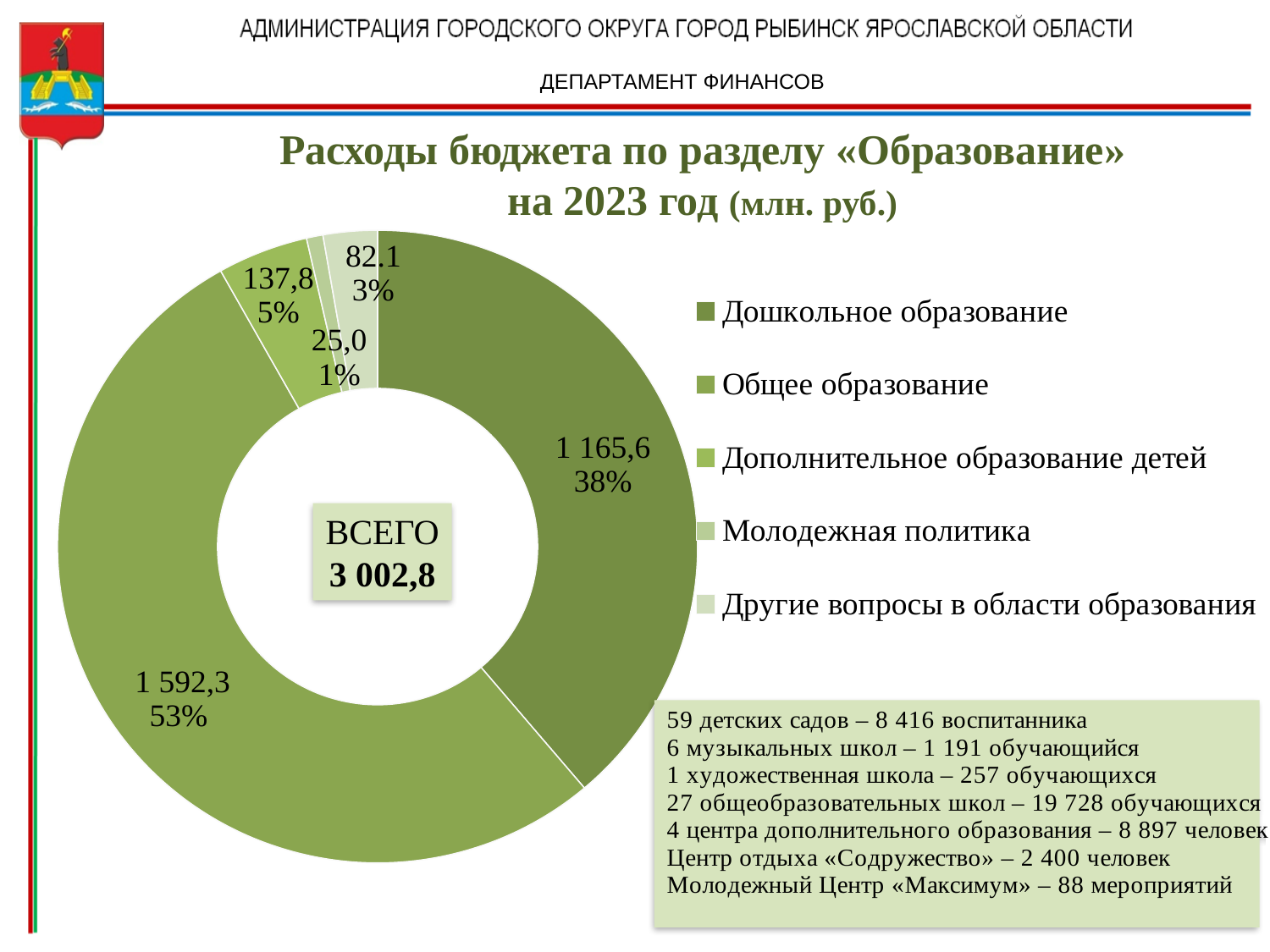
What total (ВСЕГО) is shown in the centre of the chart? 3 002,8 What share of the chart does Общее образование represent? 53% What type of chart is shown on the slide? Doughnut (pie) chart Which category has the smallest value? Молодежная политика What is the difference between the values for Общее образование and Дошкольное образование? 426,7 What is the value for Молодежная политика? 25,0 How many categories does the legend list? 5 What is the value for Дошкольное образование? 1 165,6 Which category has the largest value? Общее образование What is the value for Общее образование? 1 592,3 What is the value for Дополнительное образование детей? 137,8 What share of the chart does Другие вопросы в области образования represent? 3%